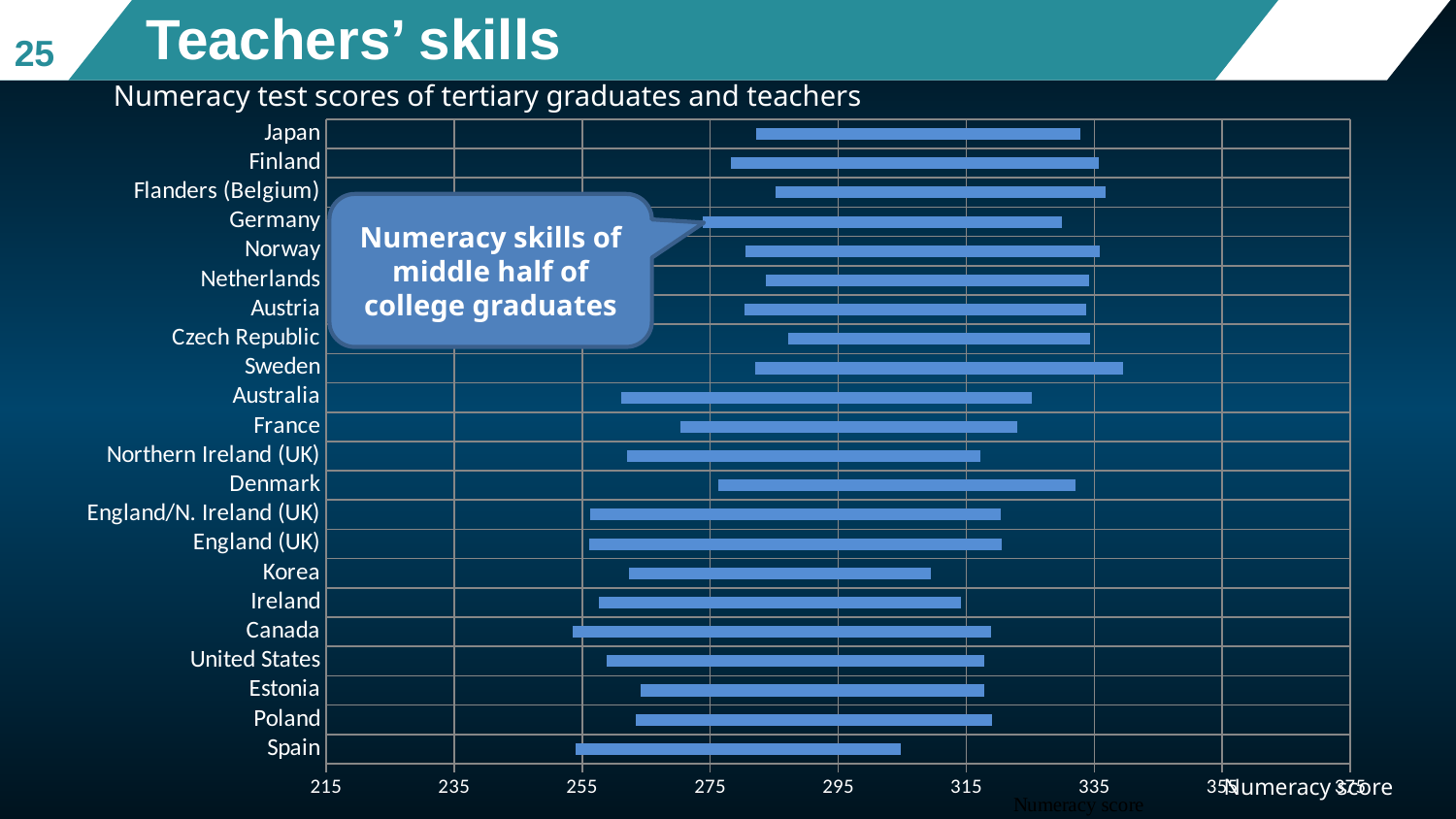
Is the upper end of Sweden's bar greater or less than 335? greater Is the upper end of Germany's bar greater or less than 335? less How many countries or regions are listed on the chart's vertical axis? 22 Which bar reaches a higher numeracy score, Sweden or Korea? Sweden Is the upper end of Korea's bar greater or less than 315? less According to the callout on the chart, what do the bars represent? Numeracy skills of middle half of college graduates Which country's bar reaches the highest numeracy score on the chart? Sweden What is the title of the chart? Numeracy test scores of tertiary graduates and teachers Which country's bar has the lowest upper end on the chart? Spain What kind of chart is shown on the slide? bar chart